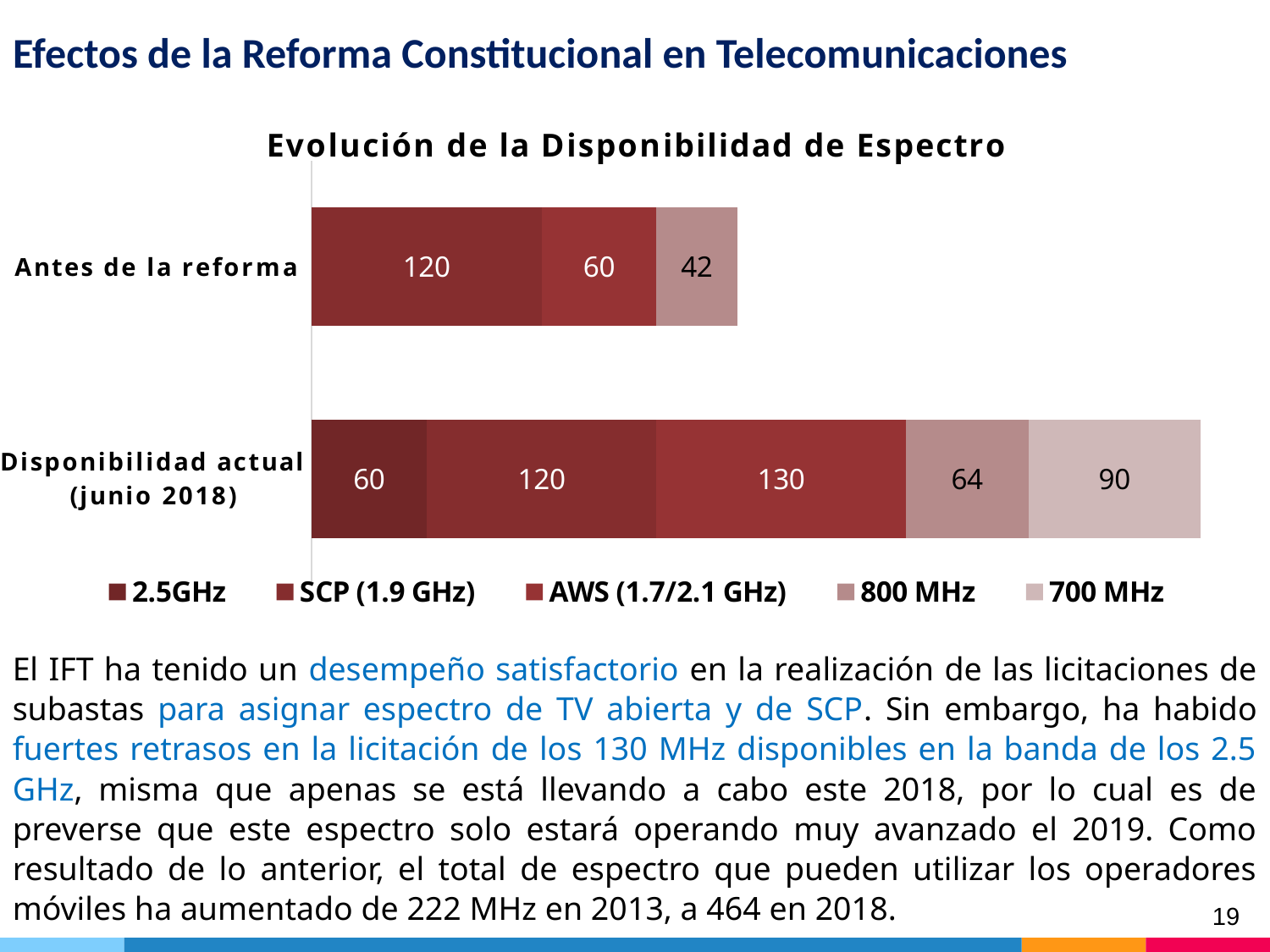
What kind of chart is shown on the slide? Stacked bar chart What is the total of the stacked bar for 'Antes de la reforma'? 222 How many categories (bars) does the chart show? 2 What is the total of the stacked bar for 'Disponibilidad actual (junio 2018)'? 464 Which bar is longer in total, 'Antes de la reforma' or 'Disponibilidad actual (junio 2018)'? Disponibilidad actual (junio 2018) What is the value of the 800 MHz segment for 'Disponibilidad actual (junio 2018)'? 64 How many series does the legend list? 5 What is the value of the AWS (1.7/2.1 GHz) segment for 'Disponibilidad actual (junio 2018)'? 130 What is the value of the 2.5GHz segment for 'Disponibilidad actual (junio 2018)'? 60 Which series has the largest segment in the 'Disponibilidad actual (junio 2018)' bar? AWS (1.7/2.1 GHz) What is the title of the chart? Evolución de la Disponibilidad de Espectro What is the value of the 700 MHz segment for 'Disponibilidad actual (junio 2018)'? 90